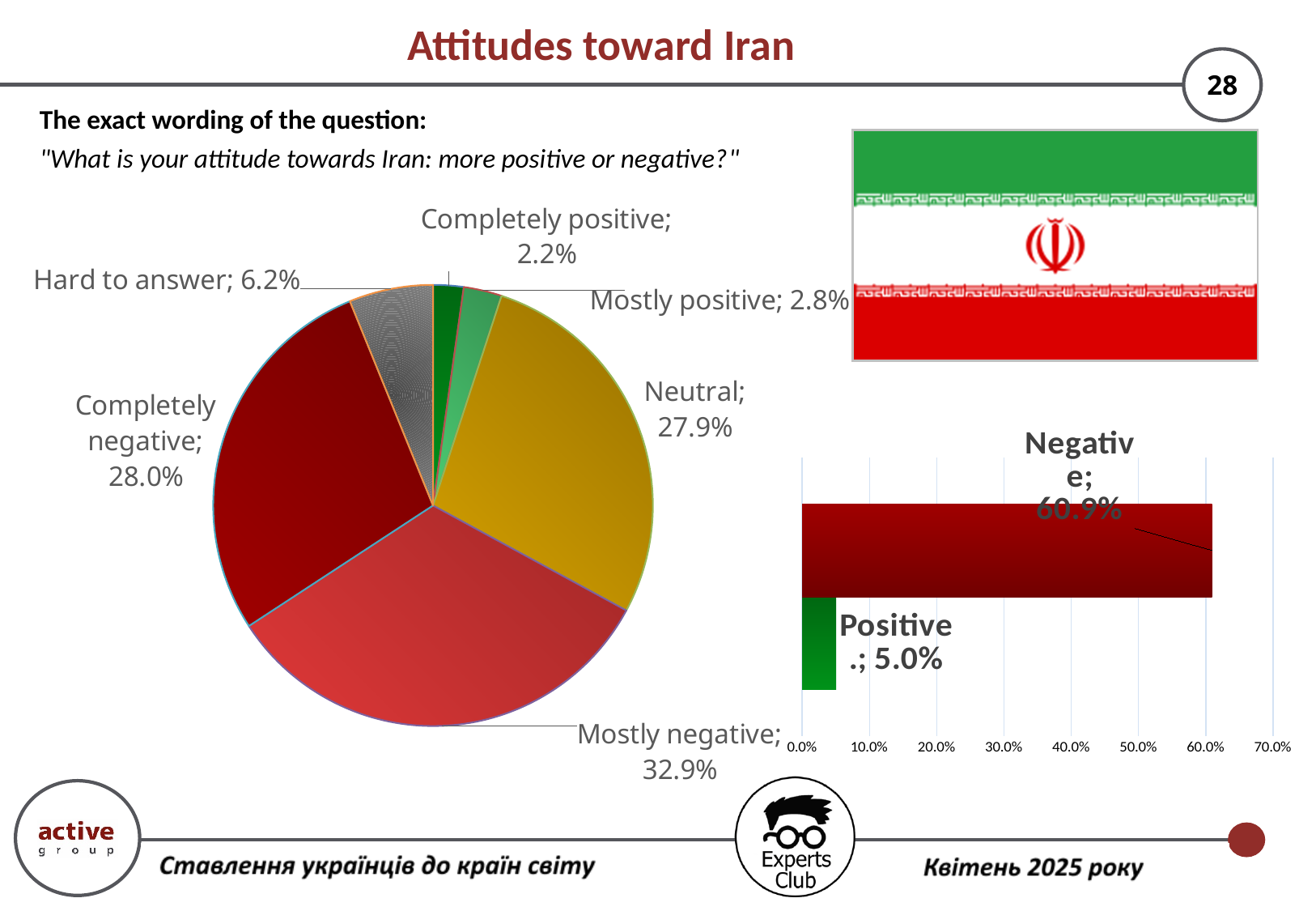
In the pie chart, which category has the largest share? Mostly negative What type of chart is shown on the right side of the slide? Bar chart In the bar chart on the right, what is the value for "Positive"? 5.0% In the bar chart on the right, what is the difference between "Negative" and "Positive"? 55.9% In the pie chart, which category has the smallest share? Completely positive In the pie chart, what share of respondents answered "Mostly negative"? 32.9% In the pie chart, what is the value for "Neutral"? 27.9% In the pie chart, which is larger: "Mostly positive" or "Completely positive"? Mostly positive In the bar chart on the right, what is the value for "Negative"? 60.9% In the pie chart, how many categories are shown? 6 In the pie chart, what is the value for "Hard to answer"? 6.2% In the pie chart, what is the difference between "Mostly negative" and "Completely negative"? 4.9%